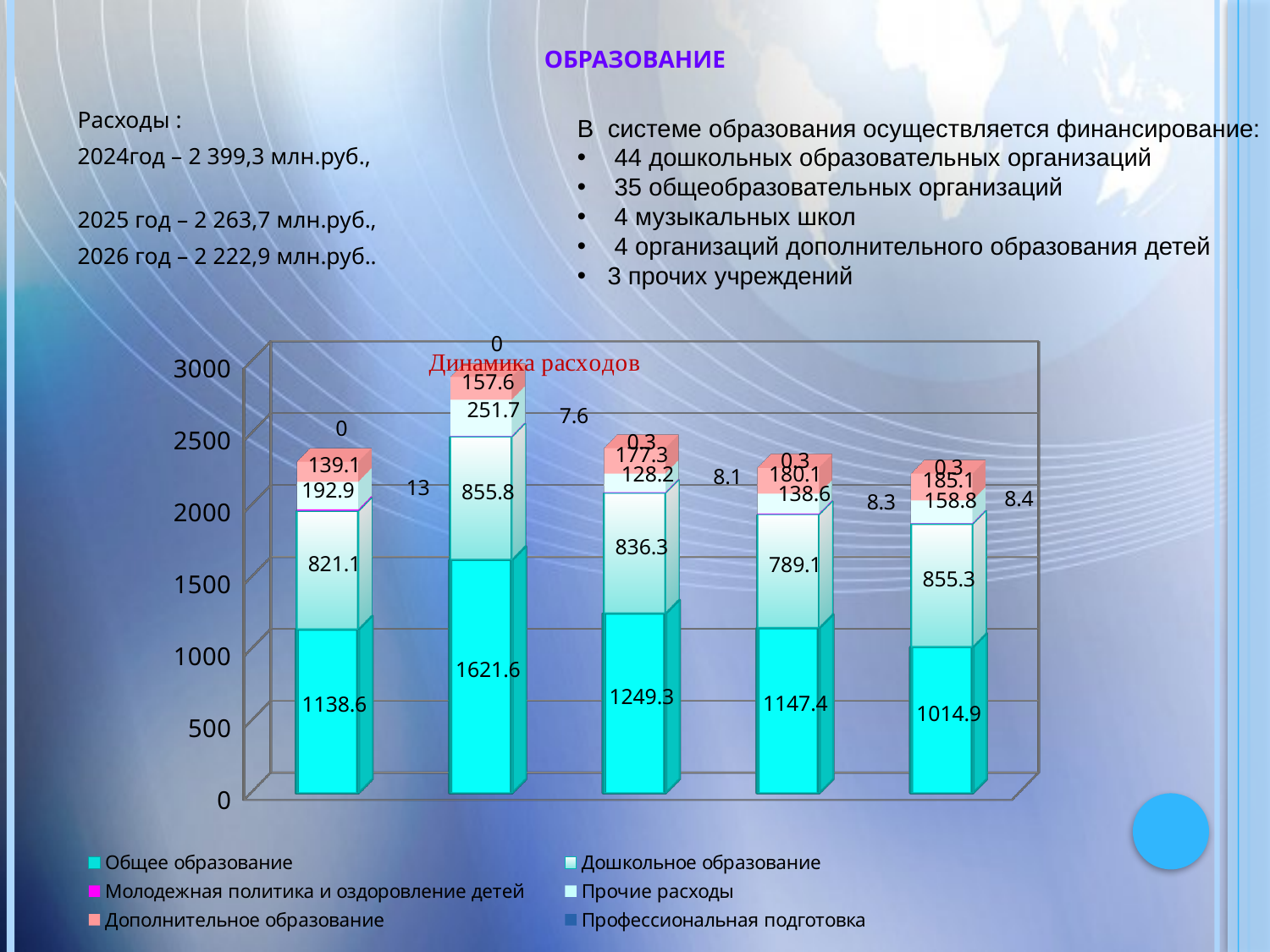
Is the total height of the leftmost stacked bar greater or less than 2000? greater What type of chart is shown on the slide? bar chart Which bar has the highest value for Общее образование? the second bar from the left (1621.6) How many stacked bars are plotted in the chart? 5 What is the value of Общее образование in the leftmost bar? 1138.6 What is the difference between the Общее образование values of the second bar and the leftmost bar? 483 Which is larger: the Общее образование value in the third bar or in the fourth bar? the third bar (1249.3) How many series does the chart legend list? 6 What is the value of Дополнительное образование in the rightmost bar? 185.1 What is the title of the chart? Динамика расходов Which bar has the lowest value for Общее образование? the rightmost bar (1014.9) What is the value of Прочие расходы in the second bar from the left? 251.7